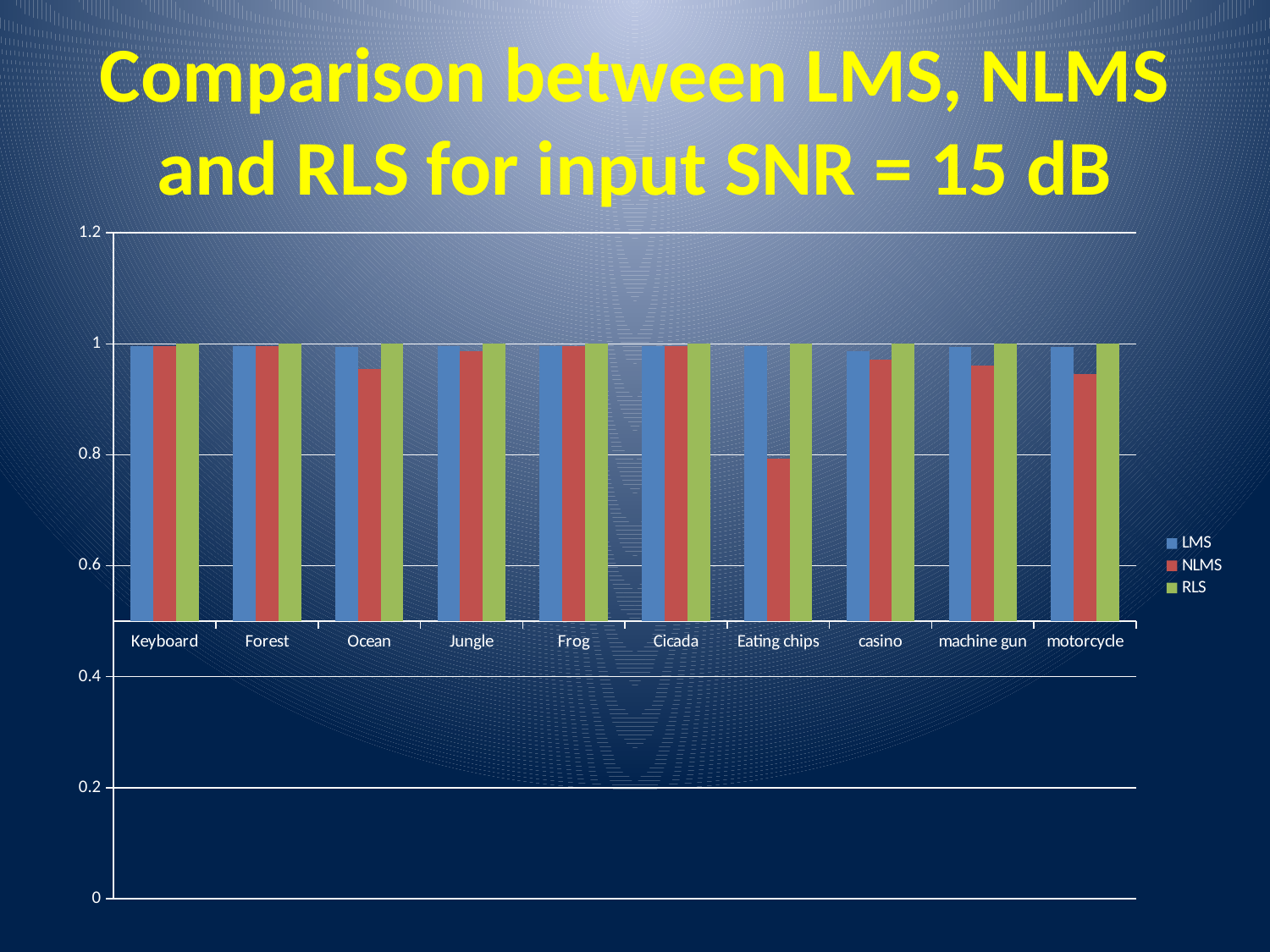
What is the title of the chart on the slide? Comparison between LMS, NLMS and RLS for input SNR = 15 dB Is the NLMS value for Ocean greater or less than 0.8? greater For motorcycle, which is larger: the LMS value or the NLMS value? LMS Is the LMS value for Keyboard greater or less than 0.8? greater Which category has the lowest NLMS value? Eating chips Which is larger: the NLMS value for Keyboard or the NLMS value for Eating chips? Keyboard How many series does the chart legend list? 3 What kind of chart is shown on the slide? bar chart Is the NLMS value for Eating chips greater or less than 1? less Which series are listed in the chart legend? LMS, NLMS, RLS For Ocean, which is larger: the NLMS value or the RLS value? RLS How many categories are shown on the x axis of the chart? 10